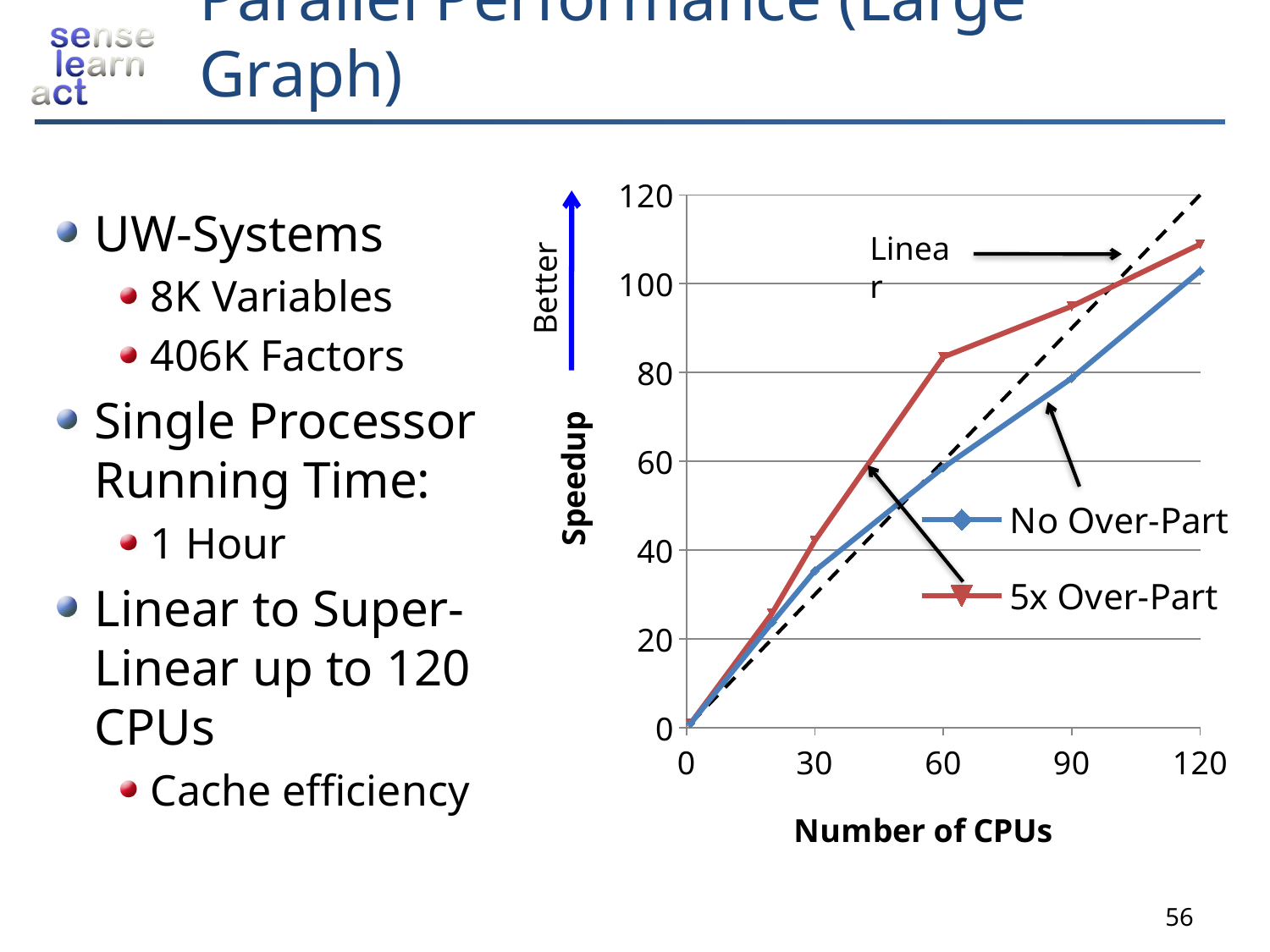
What kind of chart is shown on the slide? line chart What is the title of the x axis of the chart? Number of CPUs At 60 CPUs, which series has the higher speedup, No Over-Part or 5x Over-Part? 5x Over-Part Is the speedup for 5x Over-Part at 60 CPUs greater or less than 80? greater Is the speedup for No Over-Part at 30 CPUs greater or less than 40? less Is the speedup for 5x Over-Part at 90 CPUs greater or less than 100? less How many series does the chart legend list? 2 At 120 CPUs, which series has the higher speedup, No Over-Part or 5x Over-Part? 5x Over-Part Does the speedup for No Over-Part rise or fall as the number of CPUs increases? rise What is the title of the y axis of the chart? Speedup